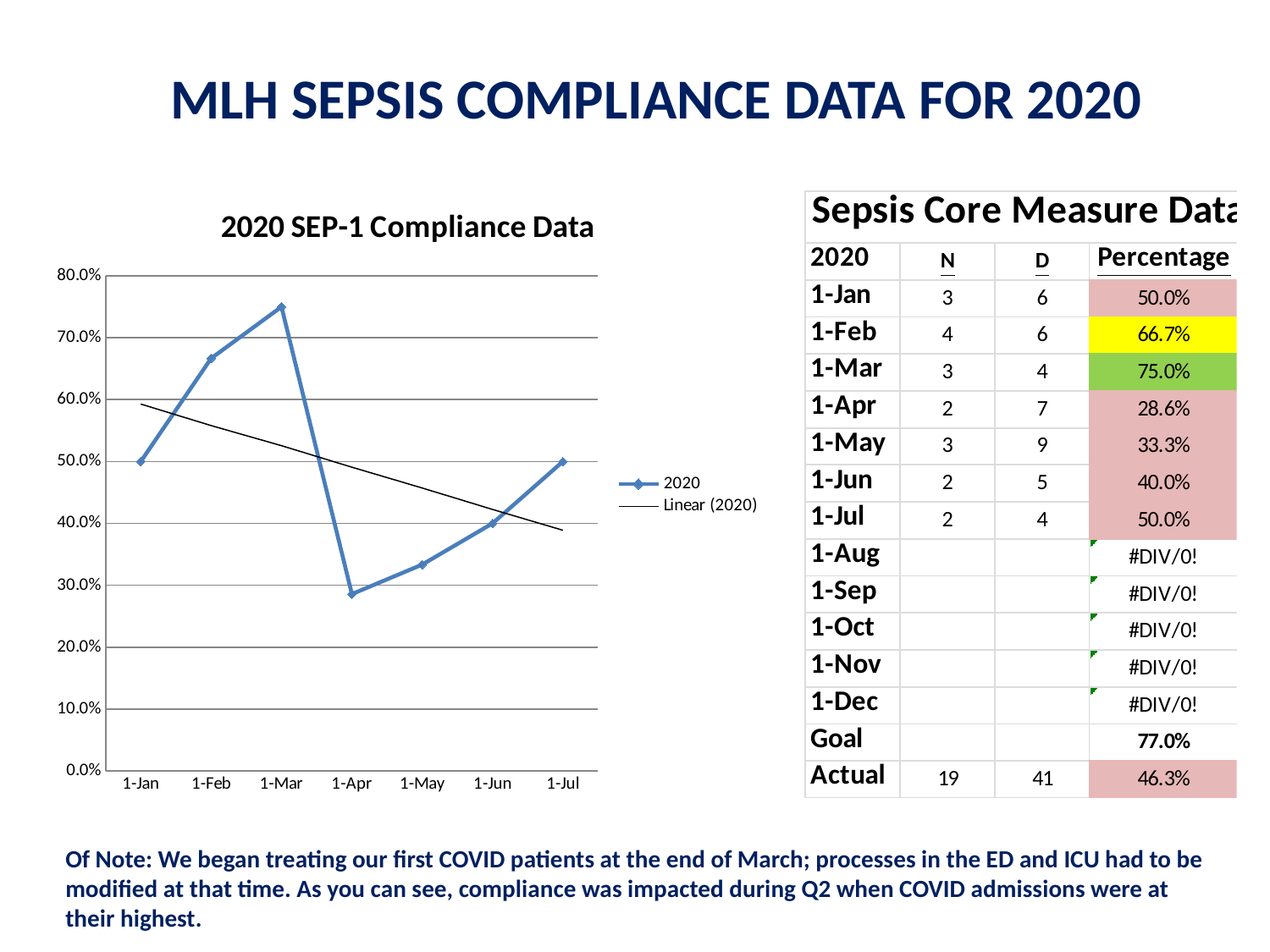
In the 2020 SEP-1 Compliance Data chart, does the linear trend line rise or fall from 1-Jan to 1-Jul? fall How many months are plotted on the x axis of the 2020 SEP-1 Compliance Data chart? 7 What kind of chart is the 2020 SEP-1 Compliance Data chart? line chart In the 2020 SEP-1 Compliance Data chart, is the value for 1-Feb greater or less than 60.0%? greater What is the title of the line chart on the slide? 2020 SEP-1 Compliance Data In the 2020 SEP-1 Compliance Data chart, which month has the highest compliance value? 1-Mar In the 2020 SEP-1 Compliance Data chart, is the value for 1-Apr greater or less than 30.0%? less In the 2020 SEP-1 Compliance Data chart, which is larger, the value for 1-May or the value for 1-Jun? 1-Jun In the 2020 SEP-1 Compliance Data chart, what is the compliance value for 1-Jan? 50.0% In the 2020 SEP-1 Compliance Data chart, which month has the lowest compliance value? 1-Apr In the 2020 SEP-1 Compliance Data chart, what is the compliance value for 1-Jul? 50.0% How many entries does the legend of the 2020 SEP-1 Compliance Data chart list? 2